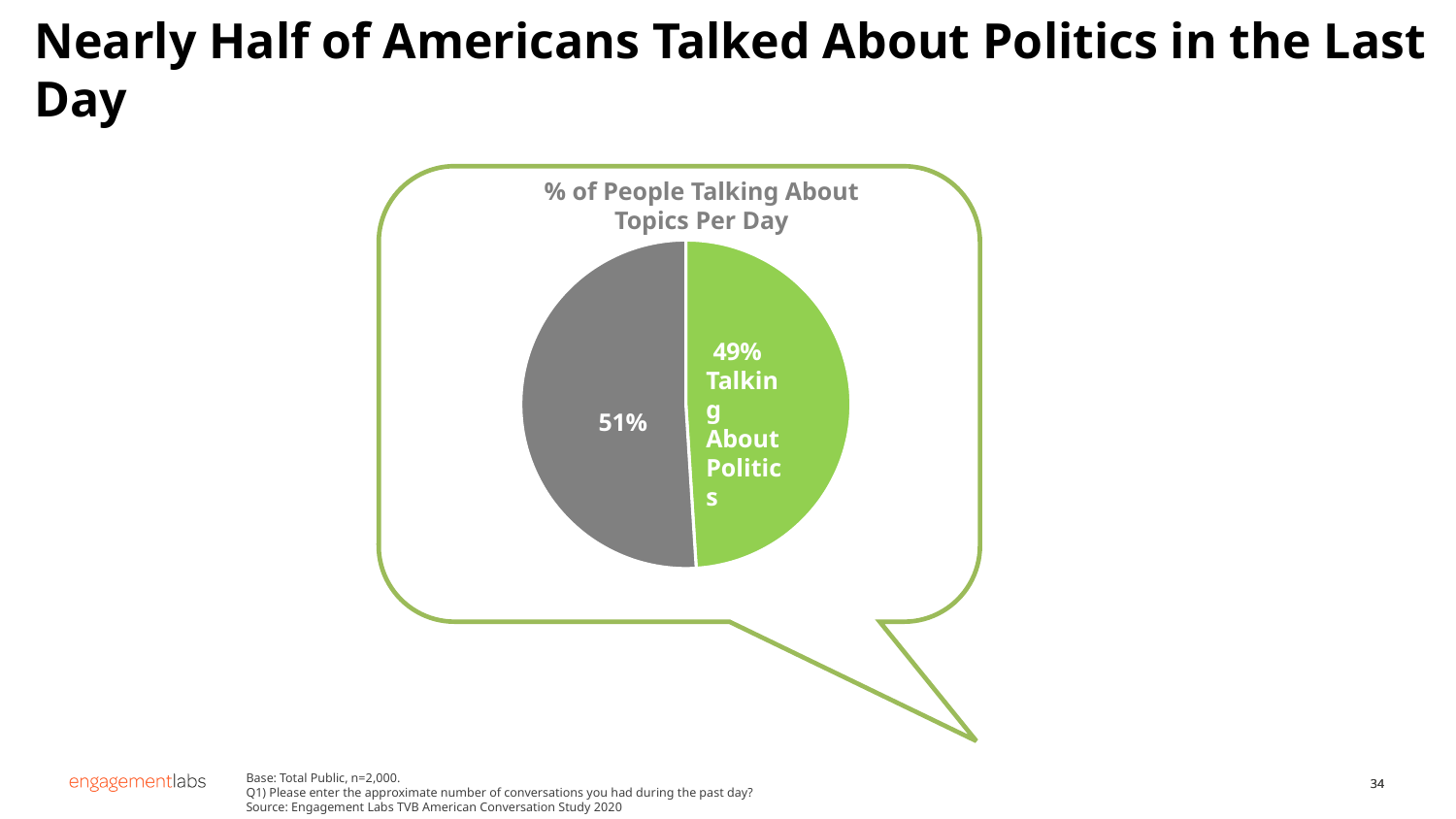
What colour is the 'Talking About Politics' slice? green Which slice of the pie is the smallest? Talking About Politics (49%) What kind of chart is shown on the slide? pie chart What percentage of people are shown as talking about politics? 49% Which slice is larger, the 'Talking About Politics' slice or the gray slice? the gray slice (51%) What value is shown on the gray slice of the pie? 51% What share of the pie does the 'Talking About Politics' slice represent? 49% What is the difference between the gray slice and the 'Talking About Politics' slice? 2% Is the value for 'Talking About Politics' greater or less than 50%? less How many slices does the pie chart have? 2 What is the chart's title? % of People Talking About Topics Per Day